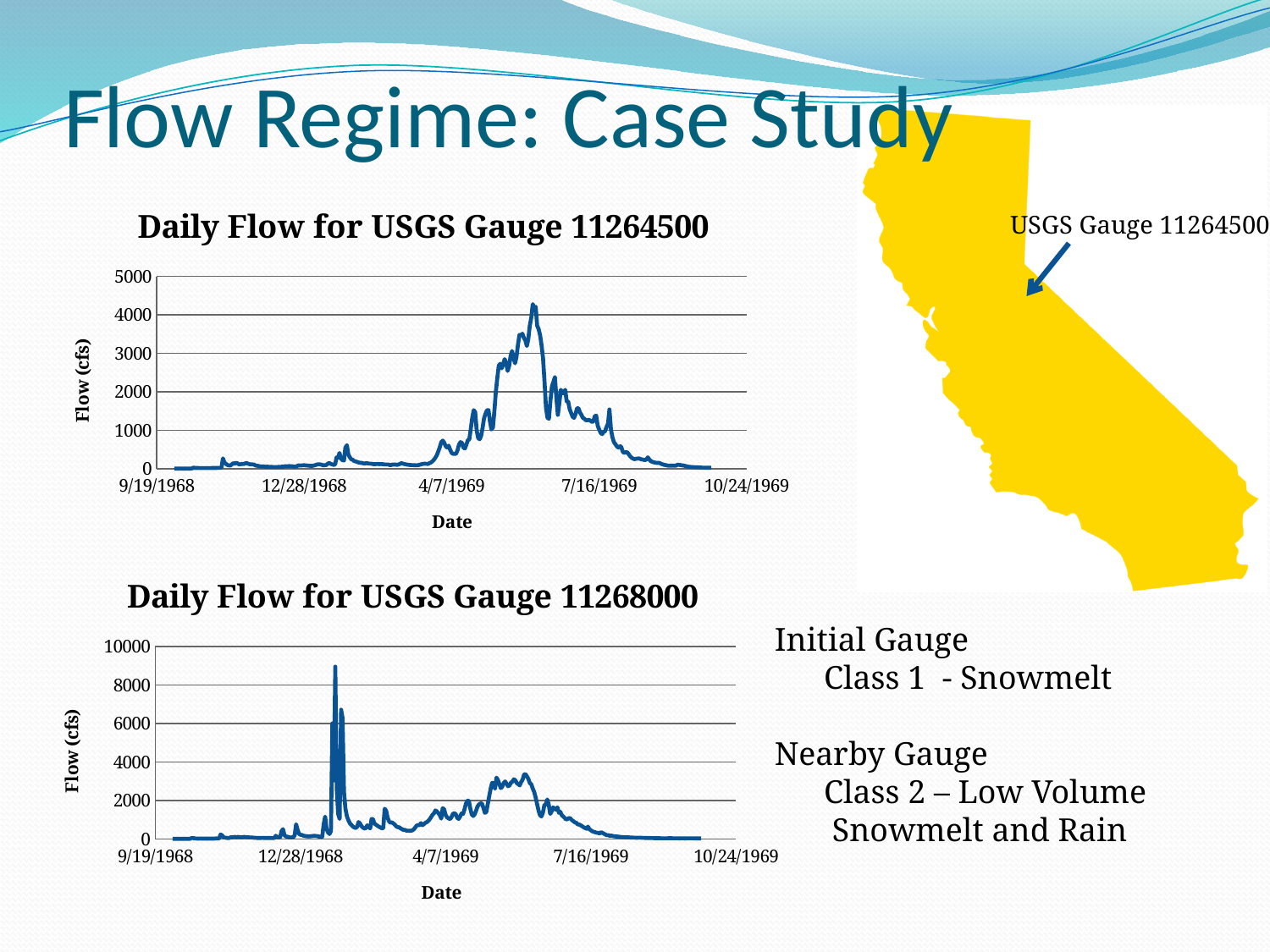
In the chart 'Daily Flow for USGS Gauge 11268000', is the flow on 7/16/1969 greater or less than 4000? less In the chart 'Daily Flow for USGS Gauge 11268000', is the peak flow greater or less than 8000? greater What kind of chart is 'Daily Flow for USGS Gauge 11268000'? line chart Which chart reaches a higher peak flow, the one for USGS Gauge 11264500 or the one for USGS Gauge 11268000? Daily Flow for USGS Gauge 11268000 What kind of chart is 'Daily Flow for USGS Gauge 11264500'? line chart What is the y-axis label of the chart 'Daily Flow for USGS Gauge 11268000'? Flow (cfs) What is the highest y-axis tick value shown on the chart 'Daily Flow for USGS Gauge 11264500'? 5000 In the chart 'Daily Flow for USGS Gauge 11264500', does the flow rise or fall between 7/16/1969 and 10/24/1969? fall How many lines are plotted in the chart 'Daily Flow for USGS Gauge 11264500'? 1 In the chart 'Daily Flow for USGS Gauge 11268000', does the flow rise or fall between 7/16/1969 and 10/24/1969? fall In the chart 'Daily Flow for USGS Gauge 11264500', is the peak flow greater or less than 3000? greater